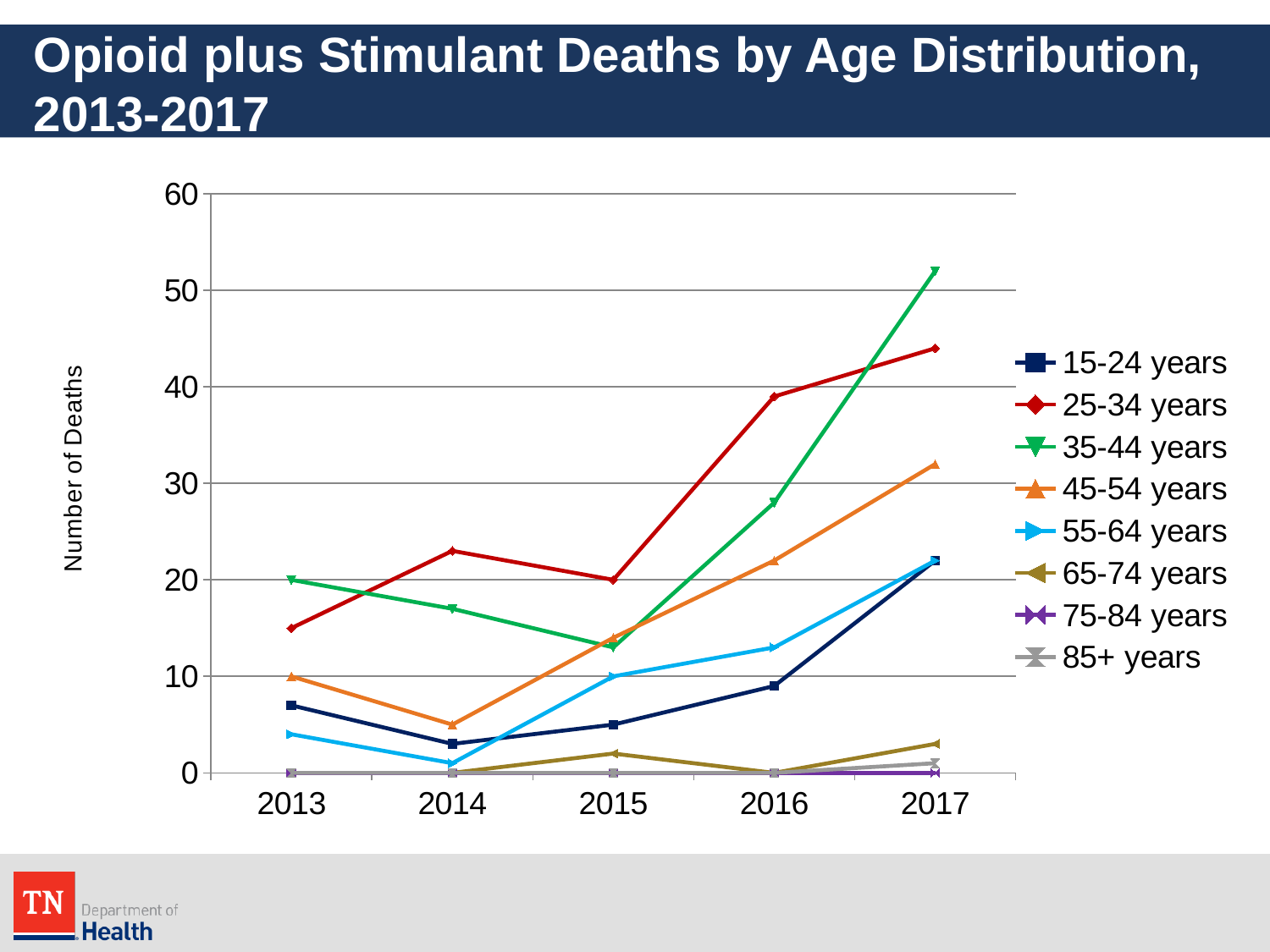
How many series does the legend list? 8 Which is larger in 2014: the value for 25-34 years or the value for 35-44 years? 25-34 years Do the values for the 35-44 years group rise or fall from 2015 to 2017? rise What is the number of deaths for the 35-44 years group in 2013? 20 What is the number of deaths for the 25-34 years group in 2015? 20 Which age group has the highest number of deaths in 2017? 35-44 years What kind of chart is shown on the slide? line chart Which age group has the highest number of deaths in 2016? 25-34 years Is the value for the 35-44 years group in 2017 greater or less than 50? greater How many years are shown along the x axis? 5 Is the value for the 45-54 years group in 2017 greater or less than 30? greater What is the number of deaths for the 45-54 years group in 2013? 10